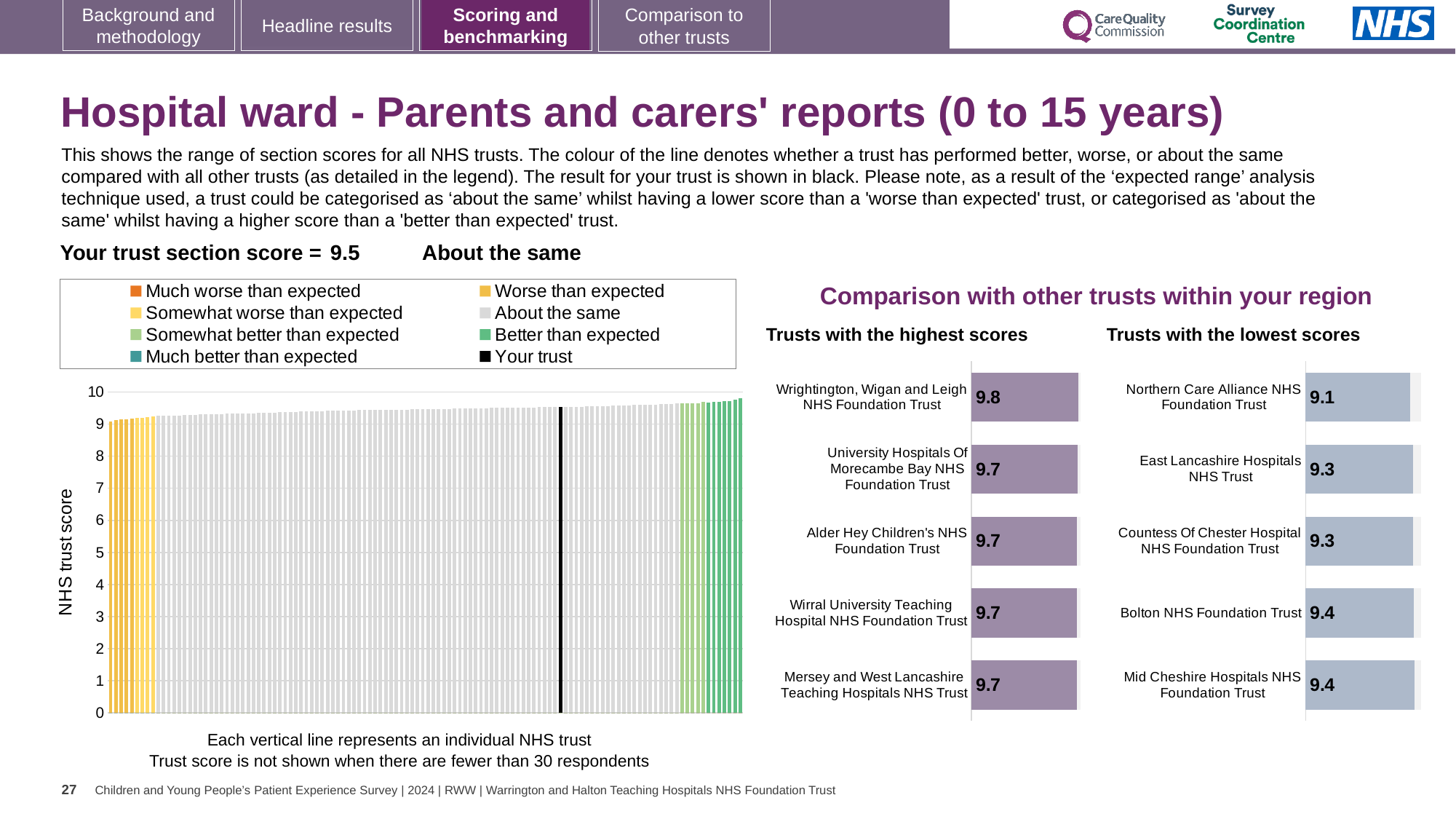
In the 'Trusts with the lowest scores' chart, what is the difference between the scores of Bolton NHS Foundation Trust and Northern Care Alliance NHS Foundation Trust? 0.3 In the 'Trusts with the lowest scores' chart, what is the score for Bolton NHS Foundation Trust? 9.4 How many trusts are listed in the 'Trusts with the highest scores' chart? 5 In the 'Trusts with the highest scores' chart, what is the difference between the score of Wrightington, Wigan and Leigh NHS Foundation Trust and Alder Hey Children's NHS Foundation Trust? 0.1 In the 'Trusts with the lowest scores' chart, what is the score for Northern Care Alliance NHS Foundation Trust? 9.1 In the 'Trusts with the lowest scores' chart, which has the larger score: East Lancashire Hospitals NHS Trust or Mid Cheshire Hospitals NHS Foundation Trust? Mid Cheshire Hospitals NHS Foundation Trust In the 'NHS trust score' chart on the left, is the value for the black 'Your trust' line greater or less than 9? greater How many entries does the legend of the 'NHS trust score' chart on the left list? 8 In the 'Trusts with the highest scores' chart, which trust has the highest score? Wrightington, Wigan and Leigh NHS Foundation Trust In the 'Trusts with the lowest scores' chart, which trust has the lowest score? Northern Care Alliance NHS Foundation Trust What kind of chart is the 'NHS trust score' chart on the left? Bar chart In the 'Trusts with the highest scores' chart, what is the score for Wrightington, Wigan and Leigh NHS Foundation Trust? 9.8